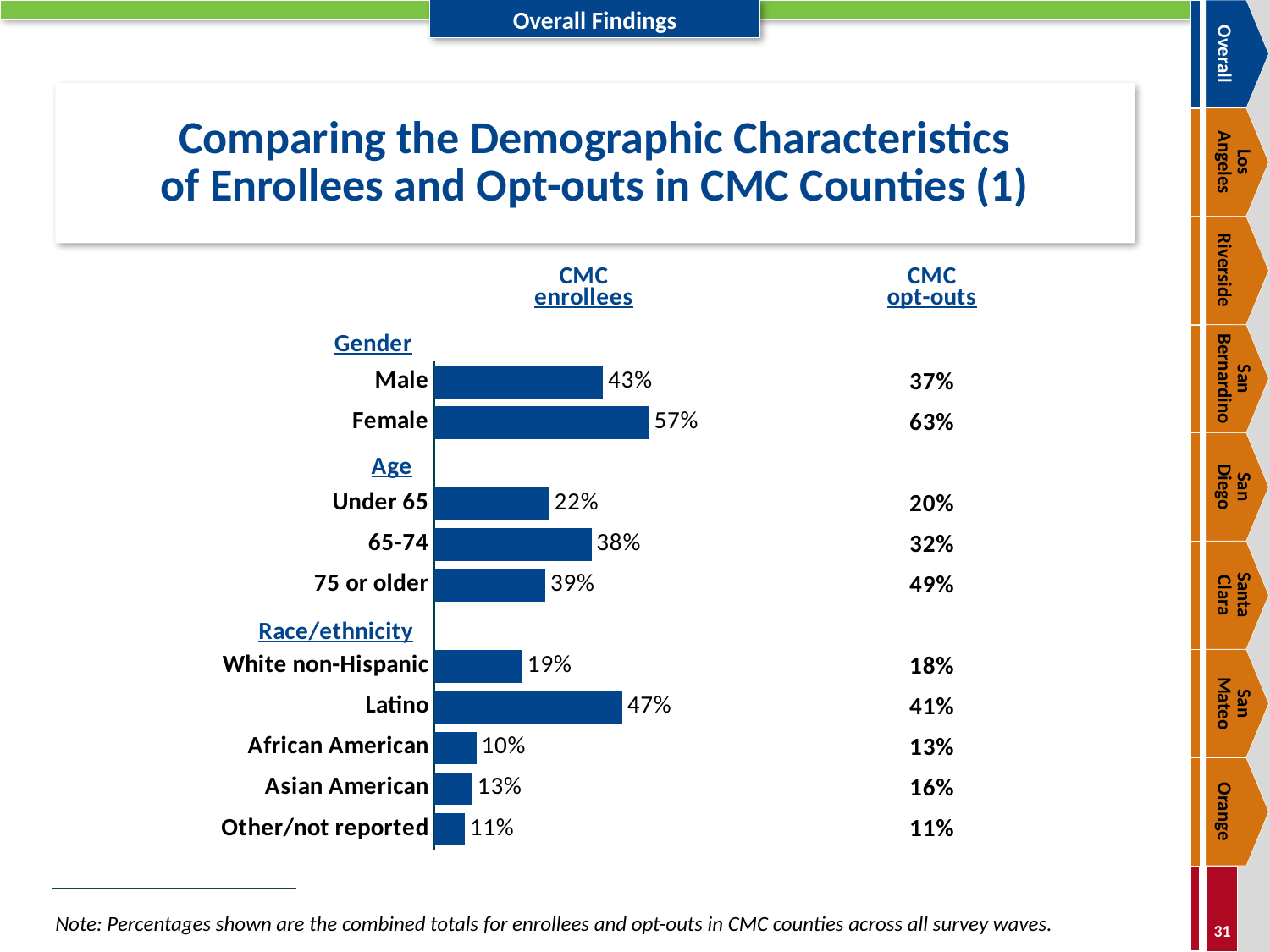
What percentage of CMC enrollees are 75 or older? 39% What percentage of CMC opt-outs are Female? 63% What is the difference between the CMC enrollees and CMC opt-outs percentages for 75 or older? 10% What colour are the bars in the CMC enrollees chart? Blue What percentage of CMC enrollees are Male? 43% What is the difference between the Female and Male percentages for CMC enrollees? 14% How many bars are plotted in the CMC enrollees chart? 10 Which is larger for CMC enrollees, the 65-74 bar or the Under 65 bar? 65-74 What percentage of CMC enrollees are Latino? 47% What type of chart is used to show the CMC enrollees percentages? Bar chart Which category has the longest bar for CMC enrollees? Female